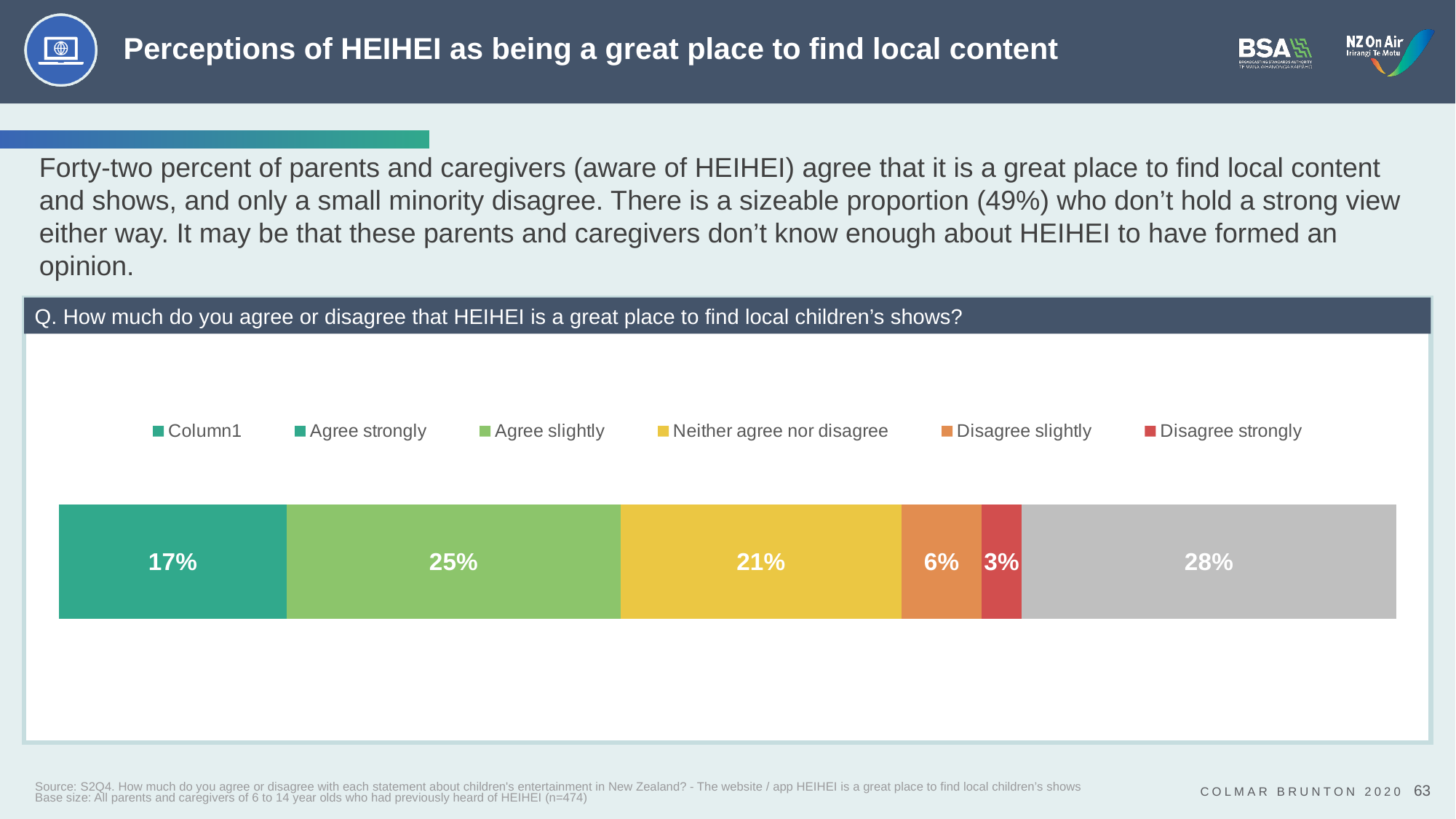
How many entries does the chart legend list? 6 Which is larger, 'Agree slightly' or 'Neither agree nor disagree'? Agree slightly What kind of chart is shown on the slide? Stacked bar chart What percentage of respondents agree slightly that HEIHEI is a great place to find local children's shows? 25% What percentage of respondents disagree slightly? 6% Which legend category has the smallest value on the bar? Disagree strongly What percentage of respondents disagree strongly? 3% What is the combined percentage of 'Agree strongly' and 'Agree slightly'? 42% What is the value shown for 'Neither agree nor disagree'? 21% What percentage of respondents agree strongly? 17% How many percentage points higher is 'Agree slightly' than 'Agree strongly'? 8 percentage points What is the largest value printed on the bar? 28%